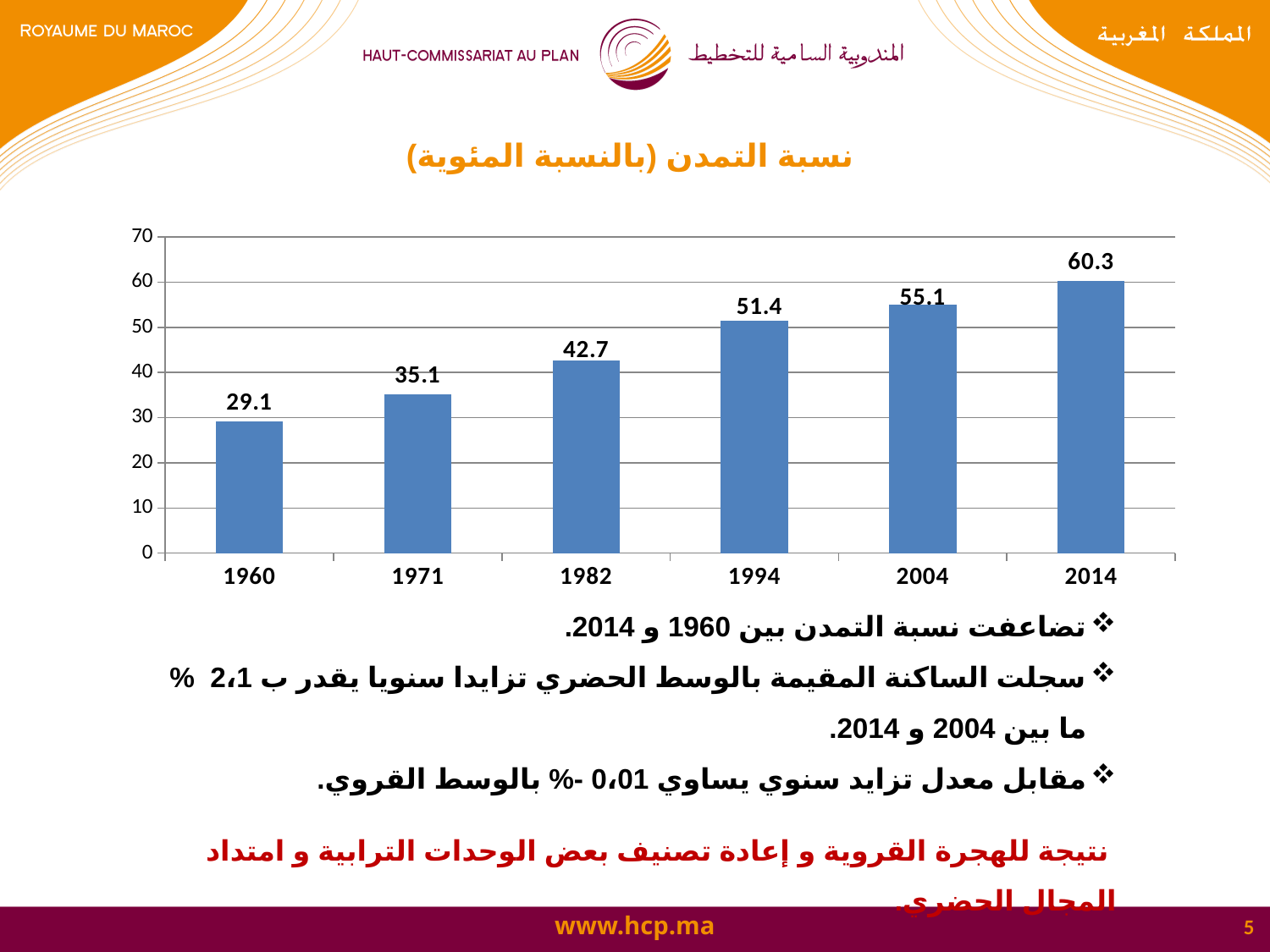
Which is larger, the value for 1971 or the value for 1994? 1994 Which year has the highest value? 2014 What is the difference between the values for 2014 and 1960? 31.2 What is the value shown for 2014? 60.3 Do the values rise or fall from 1960 to 2014? rise What kind of chart is shown on the slide? bar chart What is the urbanization rate shown for 1960? 29.1 What is the value shown for 1982? 42.7 Which year has the lowest value? 1960 Is the value for 2004 greater or less than 50? greater How many years are shown on the x axis? 6 What is the difference between the values for 2004 and 1994? 3.7